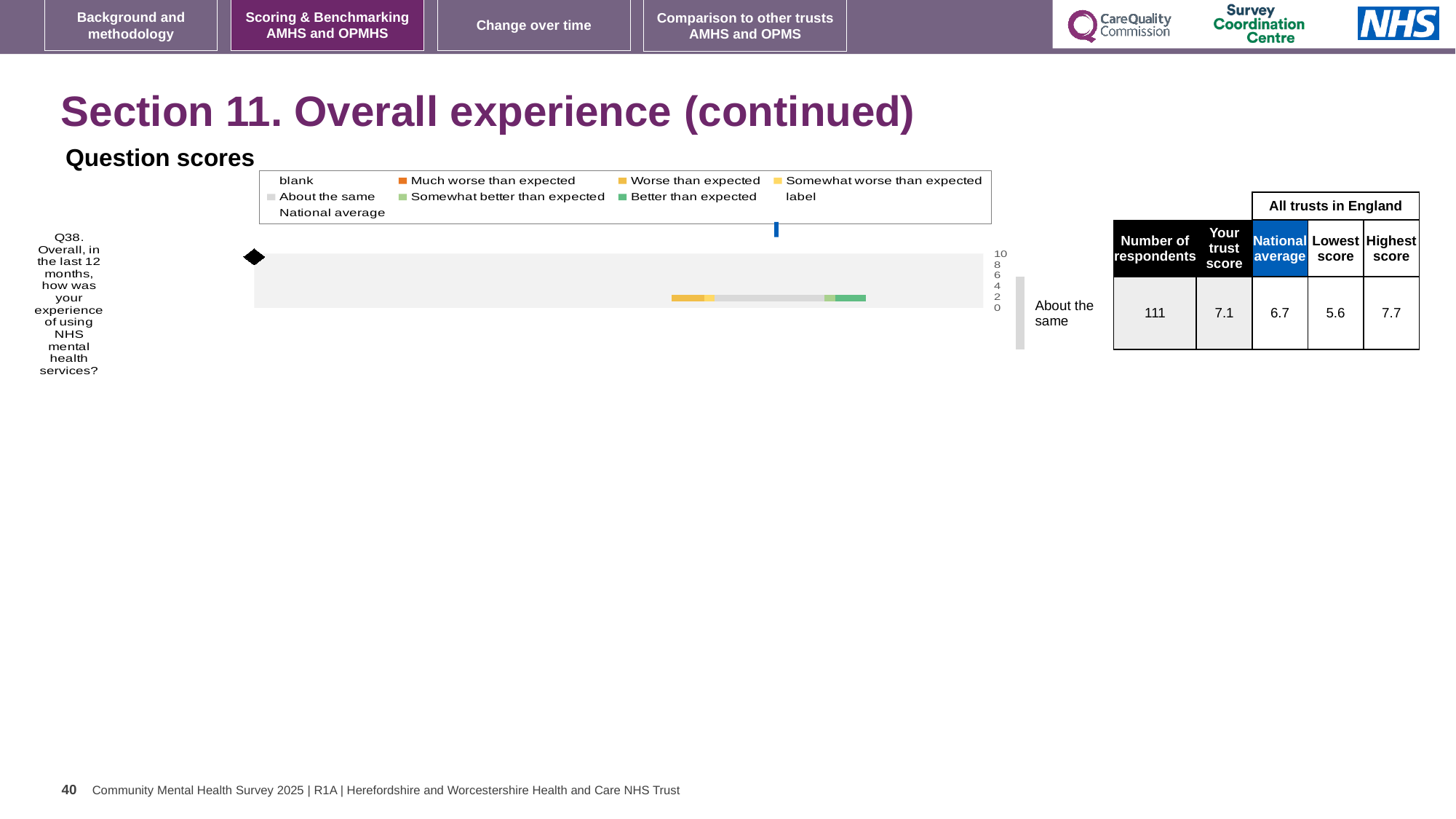
In the table beside the chart, what is the lowest score among all trusts in England for Q38? 5.6 What is the highest value shown on the chart's axis? 10 What kind of chart is shown under 'Question scores'? bar chart In the table beside the chart, what is the highest score among all trusts in England for Q38? 7.7 Is the trust score for Q38 (7.1) larger or smaller than the national average (6.7)? larger Which question is plotted in the chart? Q38. Overall, in the last 12 months, how was your experience of using NHS mental health services? In the table beside the chart, what is 'Your trust score' for Q38? 7.1 What benchmark category label is shown to the right of the Q38 bar? About the same How many questions (categories) are plotted in the chart? 1 In the table beside the chart, what is the national average for Q38? 6.7 In the table beside the chart, what is the number of respondents for Q38? 111 Which legend entry is shown in orange? Much worse than expected